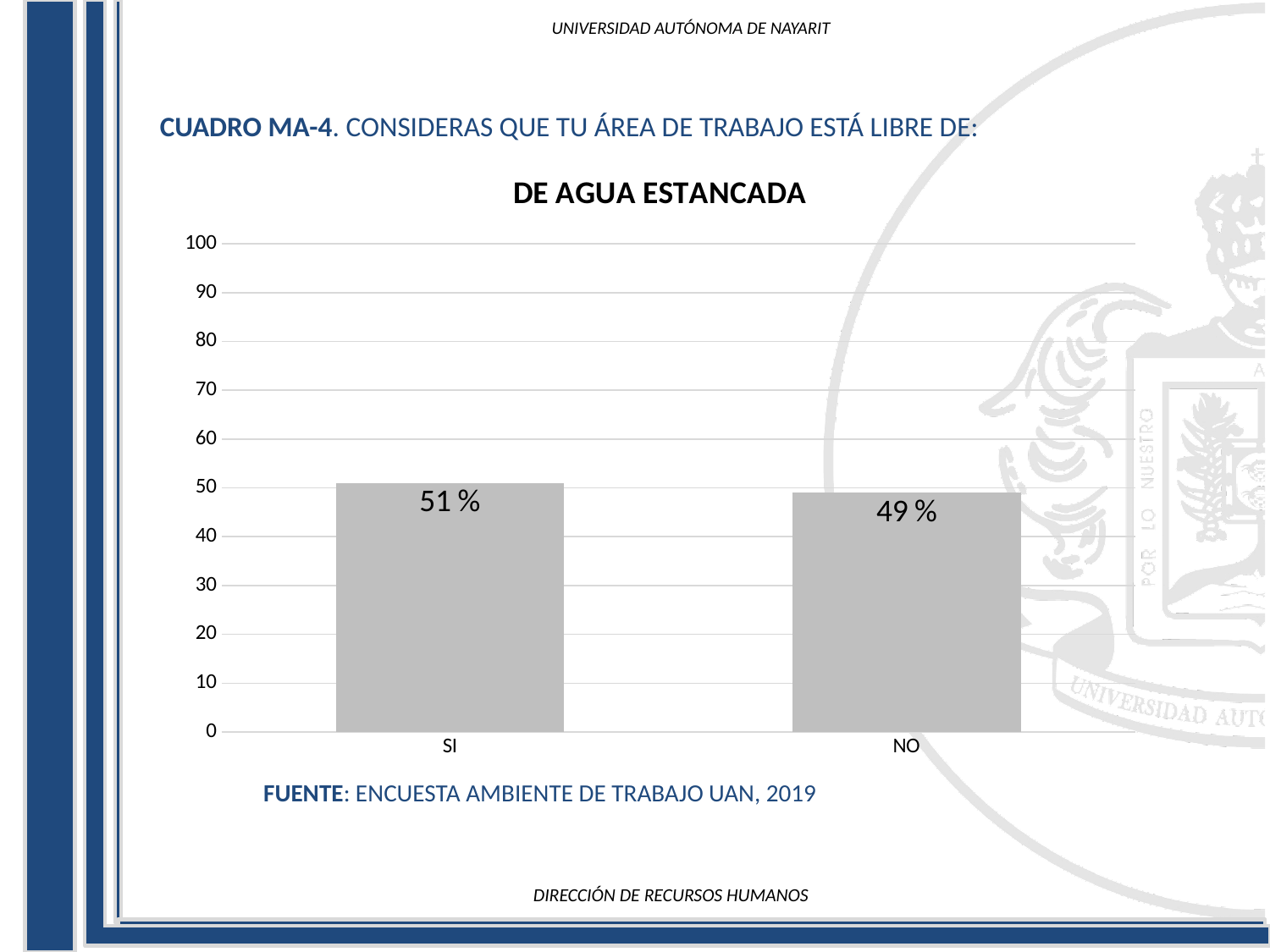
What is the title of the chart? DE AGUA ESTANCADA Which is larger, the value for SI or the value for NO? SI How many categories are shown on the x axis? 2 Which category has the highest value? SI What is the highest value shown on the y axis? 100 Which category has the lowest value? NO What is the difference between the values for SI and NO? 2 % Is the value for SI greater or less than 40? greater What is the value for SI? 51 % What kind of chart is shown on the slide? bar chart Is the value for NO greater or less than 60? less What is the value for NO? 49 %